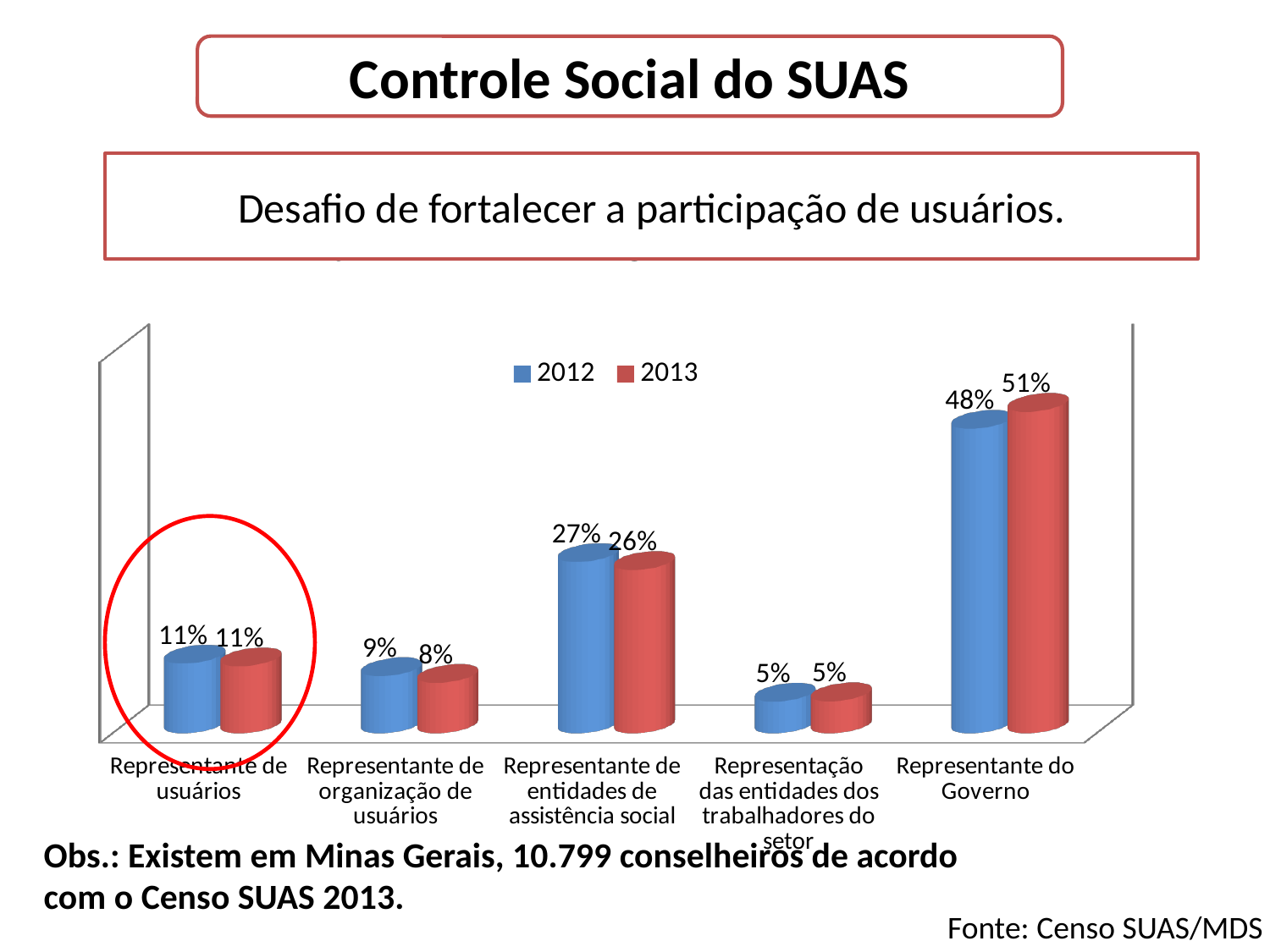
Which is larger for Representante de organização de usuários: the 2012 value or the 2013 value? 2012 What is the 2013 value for Representação das entidades dos trabalhadores do setor? 5% What is the difference between the 2013 and 2012 values for Representante do Governo? 3% What is the 2013 value for Representante do Governo? 51% How many series does the legend list? 2 What is the 2012 value for Representante de entidades de assistência social? 27% What is the 2012 value for Representante de organização de usuários? 9% What kind of chart is shown on the slide? Bar chart How many categories are shown on the x axis? 5 Which category has the lowest value in 2012? Representação das entidades dos trabalhadores do setor Which category has the highest value in 2013? Representante do Governo Which category is circled in red on the chart? Representante de usuários